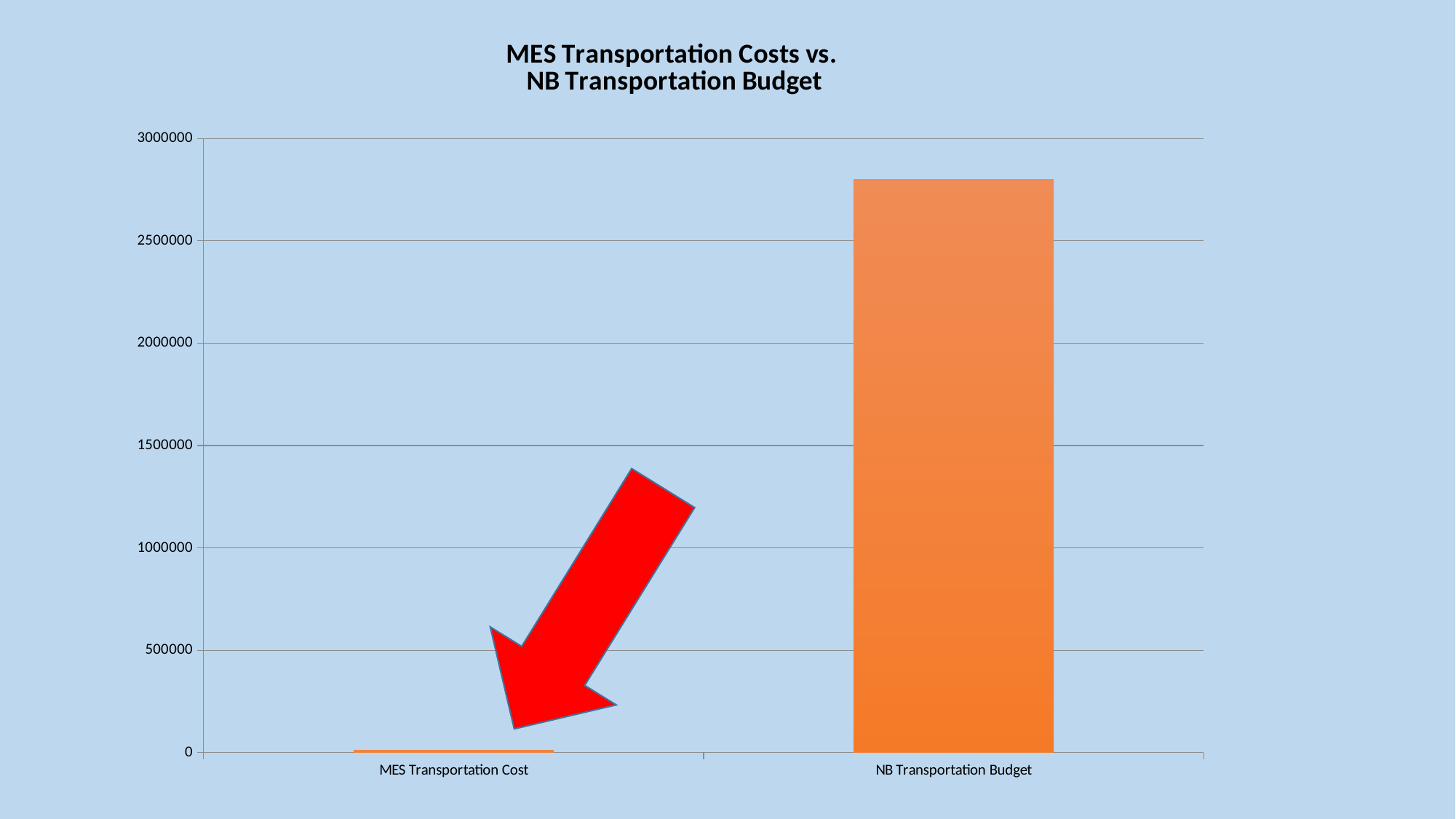
What kind of chart is shown on the slide? Bar chart Which category has the lowest value? MES Transportation Cost Do the values rise or fall moving from left to right along the x axis? Rise Is the value for NB Transportation Budget greater or less than 2500000? greater Which bar does the red arrow point to? MES Transportation Cost Is the value for MES Transportation Cost greater or less than 500000? less Is the value for NB Transportation Budget greater or less than 3000000? less Which is larger, MES Transportation Cost or NB Transportation Budget? NB Transportation Budget How many categories are plotted in the chart? 2 Which category has the highest value? NB Transportation Budget What is the title of the chart? MES Transportation Costs vs. NB Transportation Budget